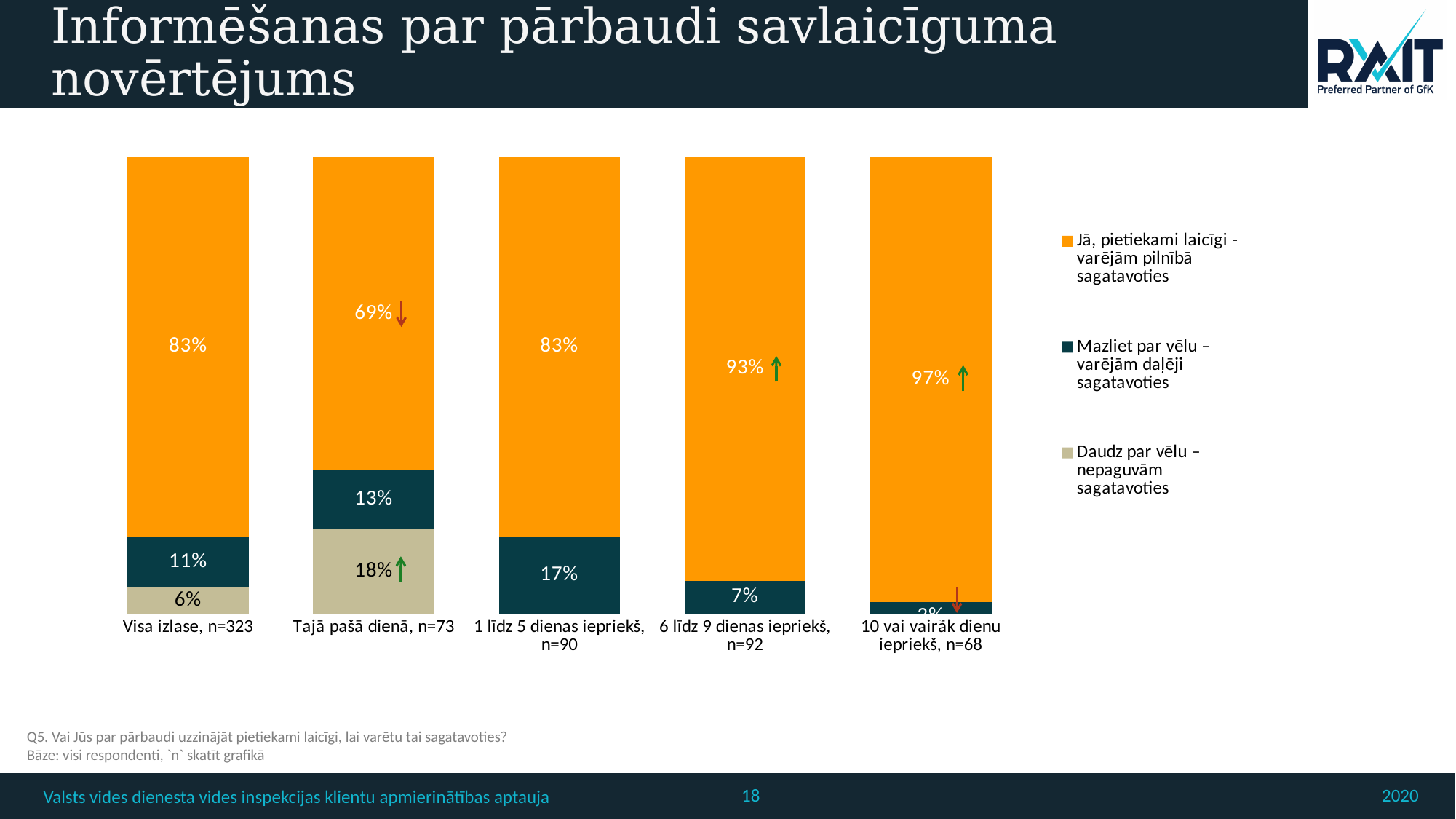
What is the value of 'Daudz par vēlu – nepaguvām sagatavoties' for 'Tajā pašā dienā, n=73'? 18% What kind of chart is shown on the slide? stacked bar chart Which category has the highest value for 'Jā, pietiekami laicīgi - varējām pilnībā sagatavoties'? 10 vai vairāk dienu iepriekš, n=68 What is the value of 'Mazliet par vēlu – varējām daļēji sagatavoties' for '1 līdz 5 dienas iepriekš, n=90'? 17% Which category has the lowest value for 'Jā, pietiekami laicīgi - varējām pilnībā sagatavoties'? Tajā pašā dienā, n=73 Which is larger: the 'Mazliet par vēlu' value for 'Tajā pašā dienā, n=73' or for '1 līdz 5 dienas iepriekš, n=90'? 1 līdz 5 dienas iepriekš, n=90 What is the difference between the 'Jā, pietiekami laicīgi' values for '10 vai vairāk dienu iepriekš, n=68' and 'Tajā pašā dienā, n=73'? 28% What is the value of 'Jā, pietiekami laicīgi - varējām pilnībā sagatavoties' for '6 līdz 9 dienas iepriekš, n=92'? 93% What is the total of the stacked bar for 'Visa izlase, n=323'? 100% How many series does the legend list? 3 What is the value of 'Jā, pietiekami laicīgi - varējām pilnībā sagatavoties' for 'Visa izlase, n=323'? 83% How many categories are shown along the x axis? 5